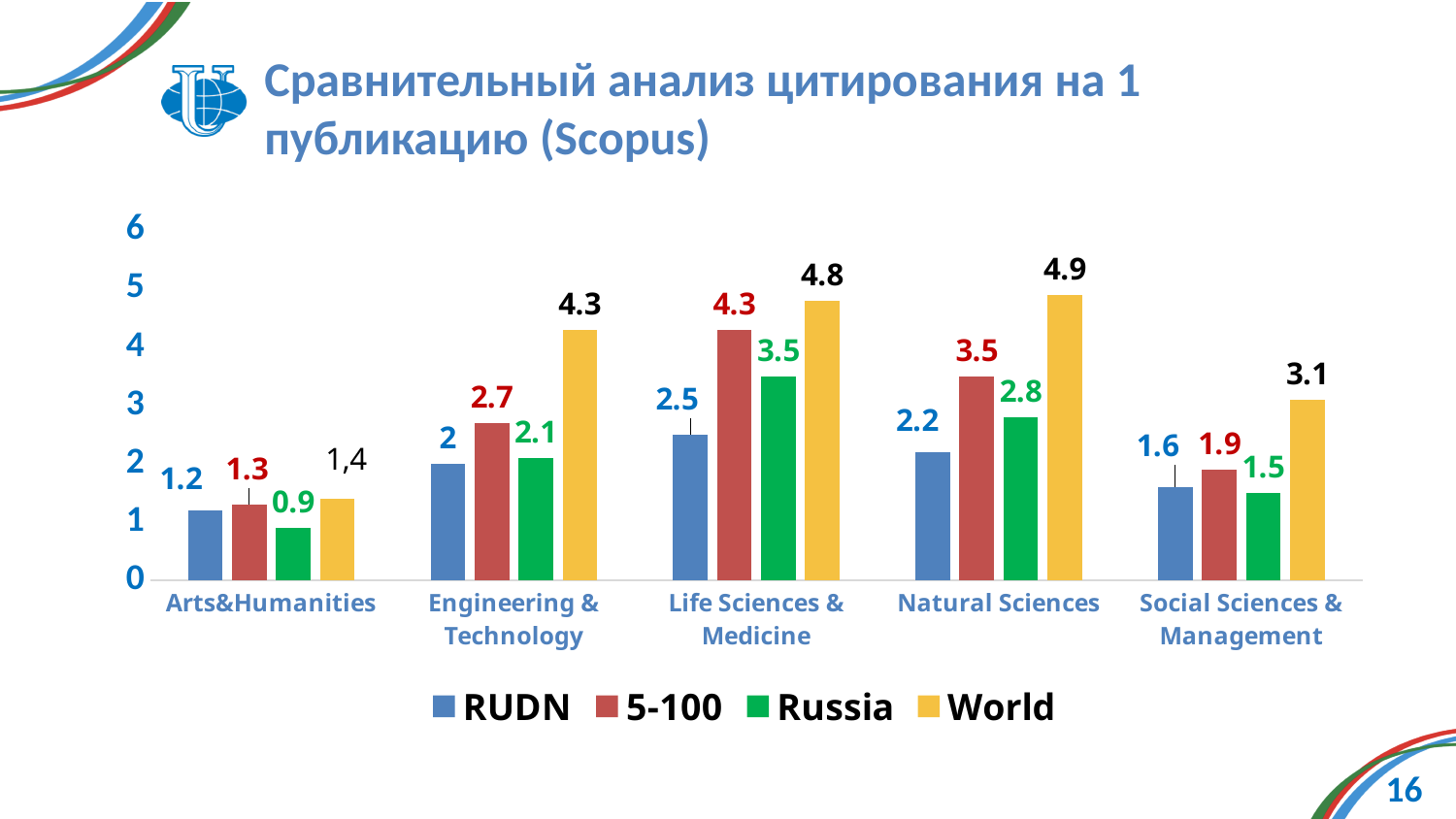
Which category has the lowest RUDN value? Arts&Humanities What is the value for World in Natural Sciences? 4.9 Is the value for World in Life Sciences & Medicine greater or less than 4? greater Which is larger in Natural Sciences: the 5-100 value or the Russia value? 5-100 What is the value for Russia in Arts&Humanities? 0.9 How many categories are shown on the x axis? 5 What kind of chart is shown on the slide? Bar chart What is the difference between the World and RUDN values in Engineering & Technology? 2.3 What is the value for 5-100 in Social Sciences & Management? 1.9 Which category has the highest World value? Natural Sciences How many series does the legend list? 4 What is the value for RUDN in Life Sciences & Medicine? 2.5